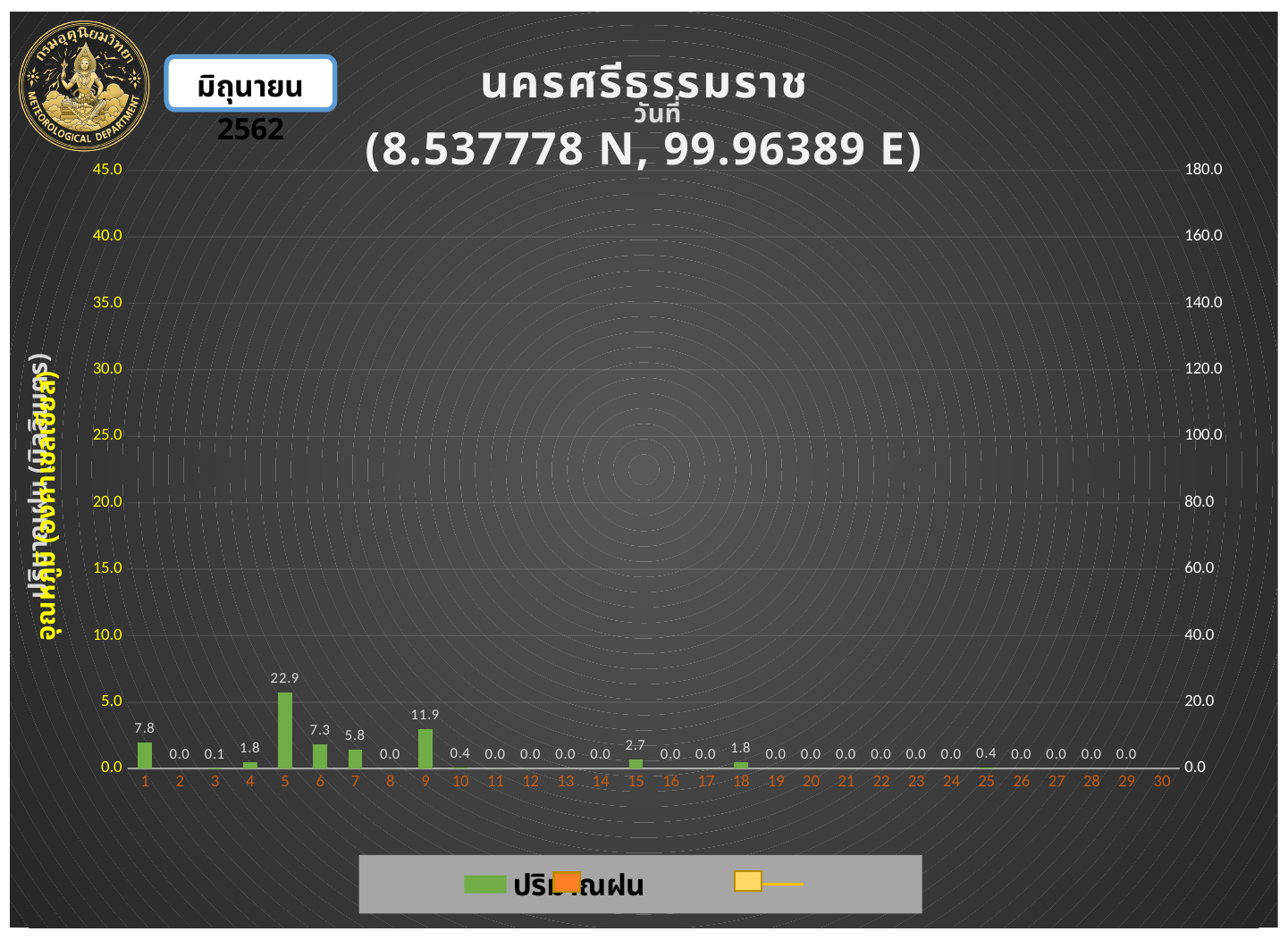
What is the rainfall value shown for day 5? 22.9 What kind of chart is shown on the slide? bar chart What is the difference between the rainfall values for day 5 and day 9? 11.0 What is the rainfall value shown for day 1? 7.8 What is the rainfall value shown for day 15? 2.7 Which has the larger rainfall value, day 1 or day 6? day 1 Which has the larger rainfall value, day 7 or day 9? day 9 What is the rainfall value shown for day 25? 0.4 Which day has the highest rainfall value? 5 What is the rainfall value shown for day 9? 11.9 What month and year are shown in the box at the top left of the slide? มิถุนายน 2562 How many days are shown on the x axis? 30